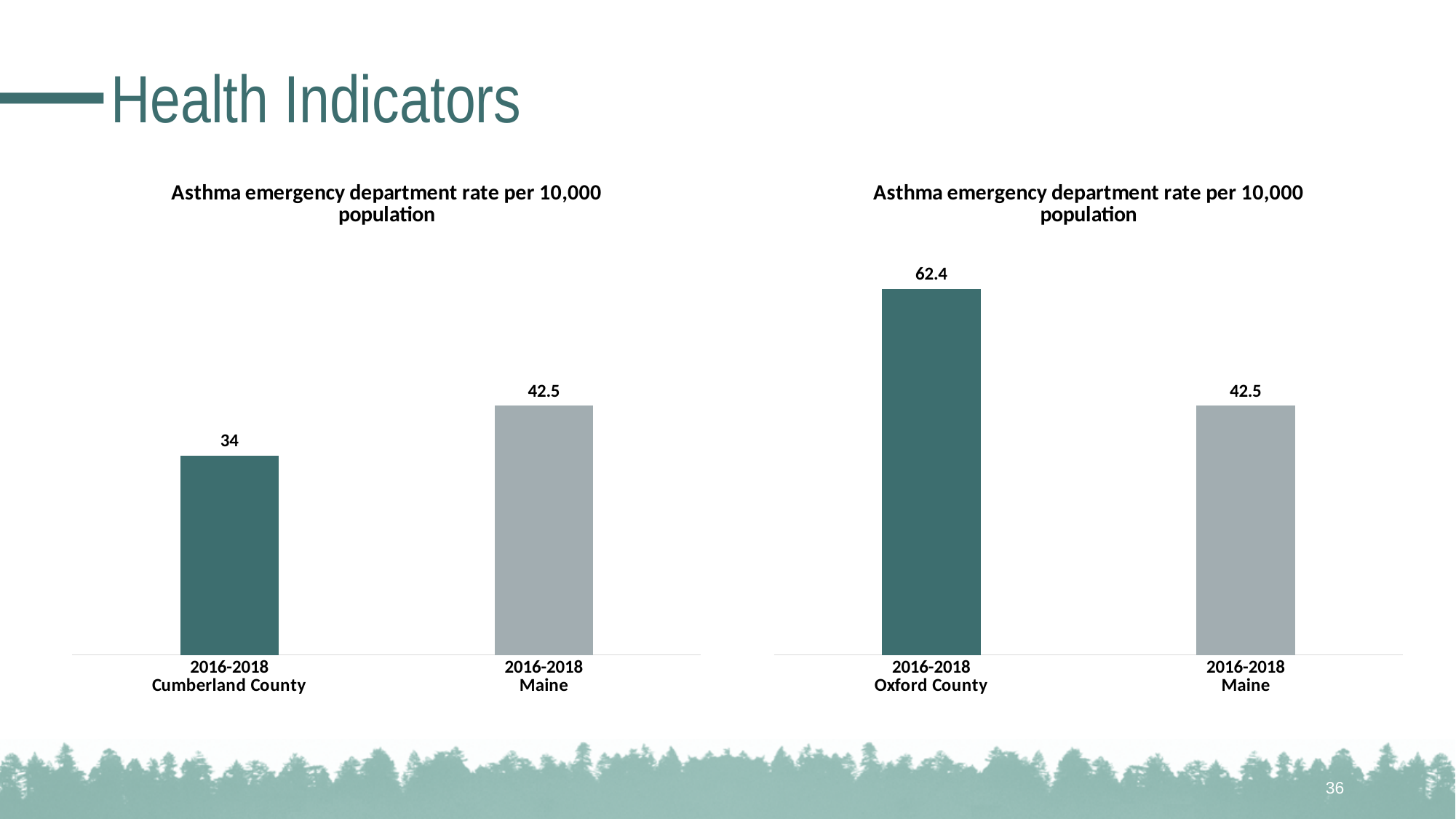
In the right chart (Oxford County), which category has the lower asthma emergency department rate? 2016-2018 Maine What is the title of the left chart? Asthma emergency department rate per 10,000 population In the left chart (Cumberland County), what is the difference between the Maine rate and the Cumberland County rate? 8.5 In the left chart (Cumberland County), which category has the higher asthma emergency department rate? 2016-2018 Maine In the right chart (Oxford County), what is the difference between the Oxford County rate and the Maine rate? 19.9 How many bars are plotted in the left chart (Cumberland County)? 2 In the left chart (Cumberland County), what is the asthma emergency department rate per 10,000 population for 2016-2018 Maine? 42.5 In the right chart (Oxford County), what is the asthma emergency department rate per 10,000 population for 2016-2018 Maine? 42.5 In the right chart (Oxford County), is the rate for Oxford County larger or smaller than the rate for Maine? larger What type of chart is the right chart (Oxford County)? bar chart In the left chart (Cumberland County), what is the asthma emergency department rate per 10,000 population for 2016-2018 Cumberland County? 34 In the right chart (Oxford County), what is the asthma emergency department rate per 10,000 population for 2016-2018 Oxford County? 62.4